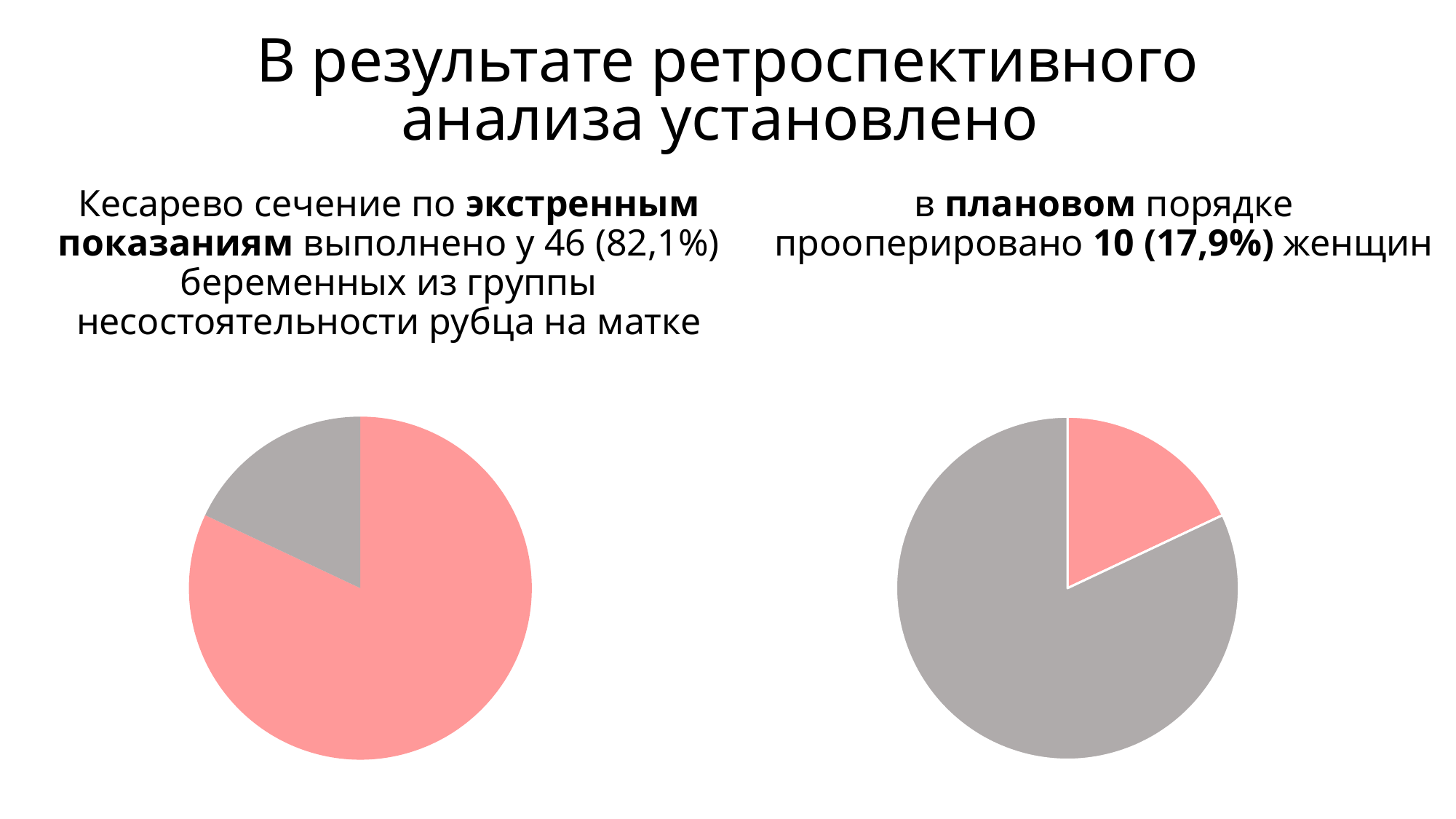
How many slices does the left pie chart have? 2 Which two colours are used for the slices in both pie charts? pink and grey According to the text above the right pie chart, what share of the group does the pink slice (planned caesarean section) represent? 17,9% Does either pie chart on the slide display a legend? No In the left pie chart, which slice is larger, the pink one or the grey one? the pink one In the left pie chart, which colour is the largest slice? pink According to the text above the left pie chart, what share of the group does the pink slice (emergency caesarean section) represent? 82,1% What kind of chart is the chart on the left of the slide? pie chart How many slices does the right pie chart have? 2 What kind of chart is the chart on the right of the slide? pie chart In the right pie chart, which colour is the smallest slice? pink In the right pie chart, which slice is larger, the pink one or the grey one? the grey one